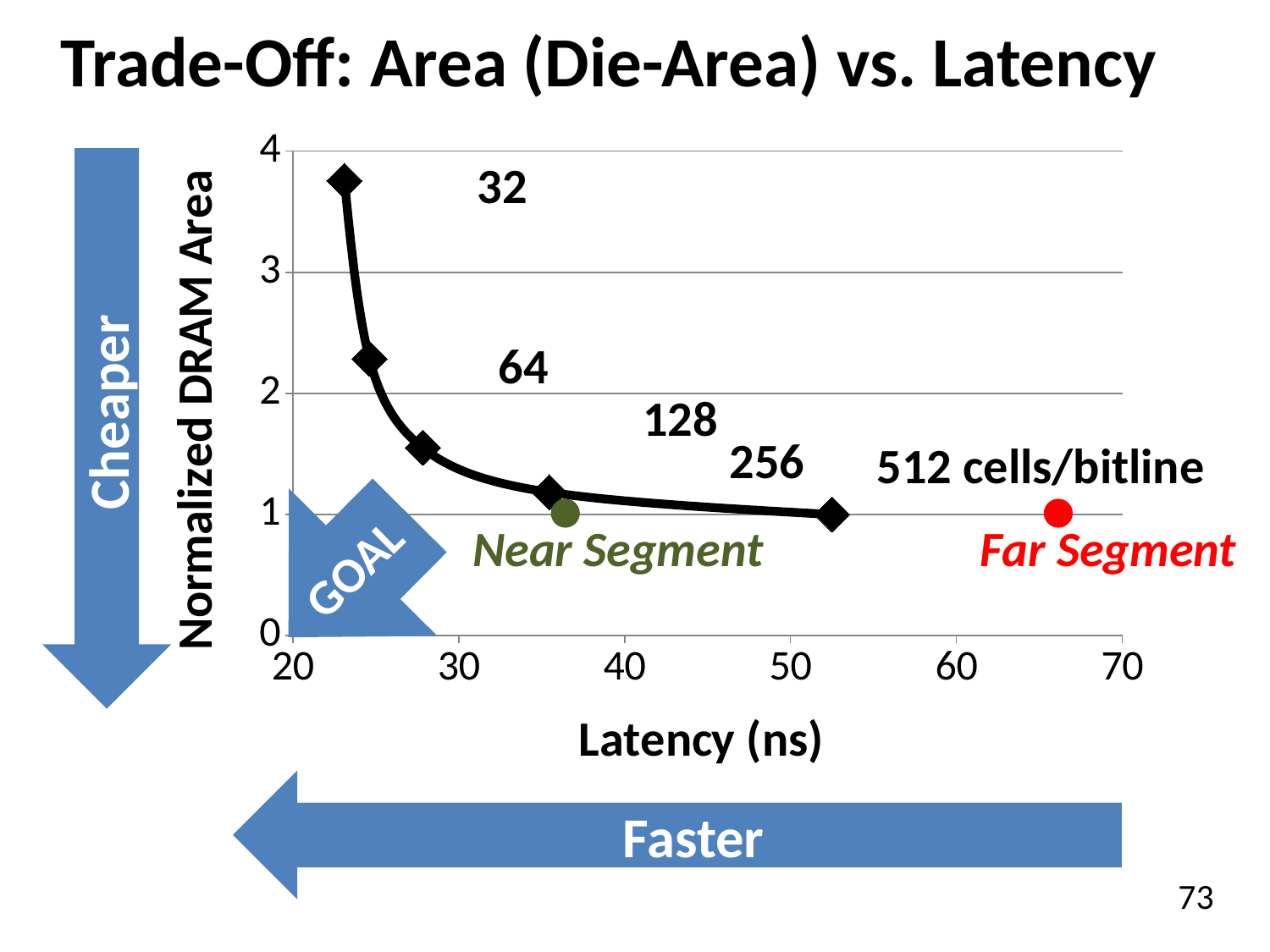
What kind of chart is shown on the slide? Line chart (scatter with connected points) Which cells/bitline configuration has the highest latency on the black curve? 512 What is the label of the x axis? Latency (ns) Is the latency for 512 cells/bitline greater or less than 50 ns? greater As latency increases along the x axis, does the Normalized DRAM Area rise or fall? fall Which cells/bitline configuration has the highest Normalized DRAM Area? 32 Is the Normalized DRAM Area for 128 cells/bitline greater or less than 2? less How many cells/bitline data points are plotted on the black curve? 5 Is the Normalized DRAM Area for 32 cells/bitline greater or less than 3? greater Which cells/bitline configuration has the lowest Normalized DRAM Area? 512 Which has a larger Normalized DRAM Area, 64 cells/bitline or 128 cells/bitline? 64 cells/bitline